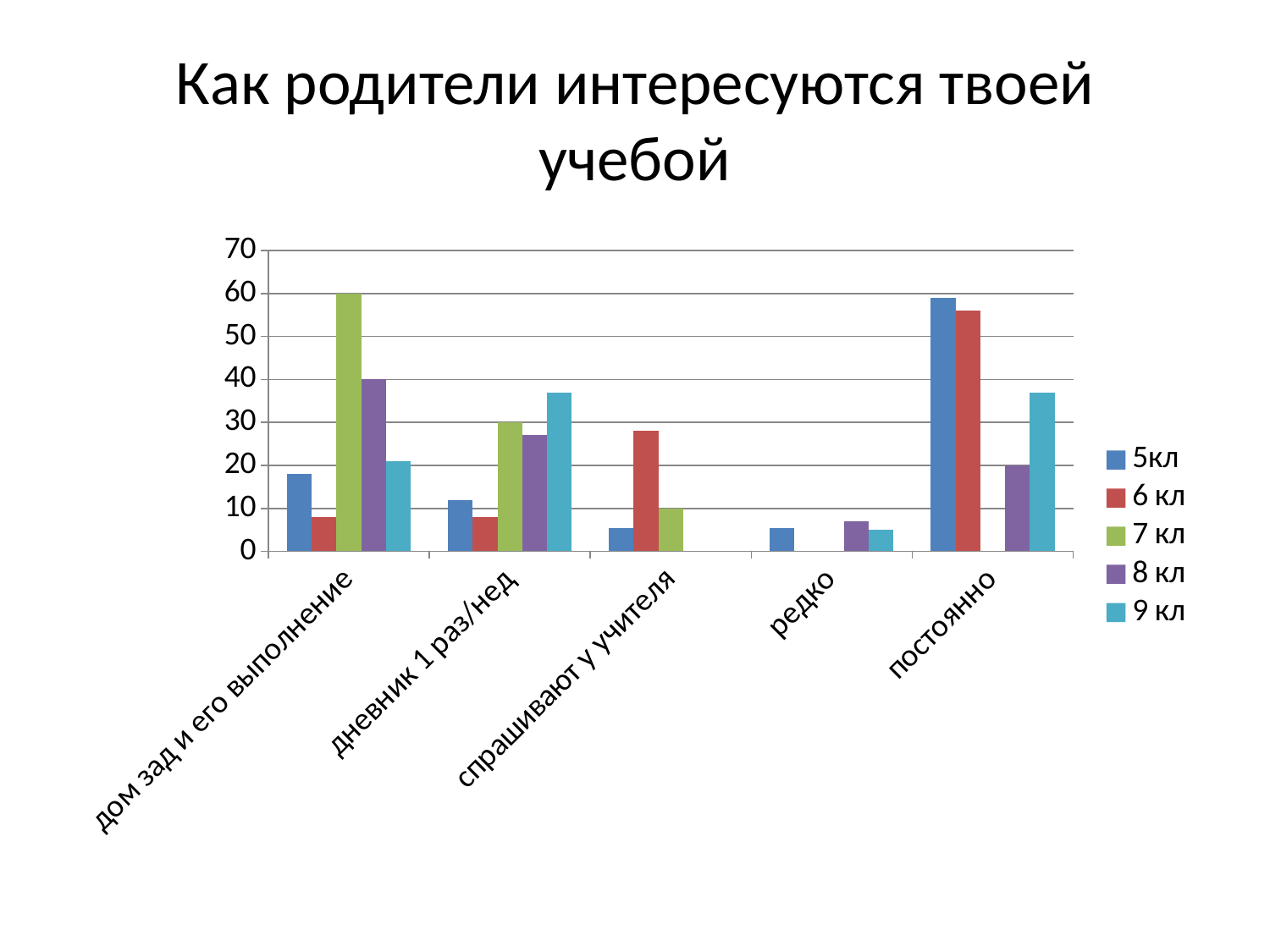
Is the value for '6 кл' in the category 'спрашивают у учителя' greater or less than 20? greater What is the title of the chart? Как родители интересуются твоей учебой Is the value for '7 кл' in the category 'дом зад и его выполнение' greater or less than 50? greater For the category 'дом зад и его выполнение', which series has the lowest bar? 6 кл For the category 'дом зад и его выполнение', which series has the highest bar? 7 кл In the category 'постоянно', which is larger: the value for '5кл' or for '8 кл'? 5кл How many categories are shown on the x axis? 5 In the category 'дневник 1 раз/нед', which is larger: the value for '9 кл' or for '5кл'? 9 кл For the series '5кл', which category has the highest value? постоянно How many series does the legend list? 5 What kind of chart is shown on the slide? bar chart Is the value for '8 кл' in the category 'постоянно' greater or less than 30? less